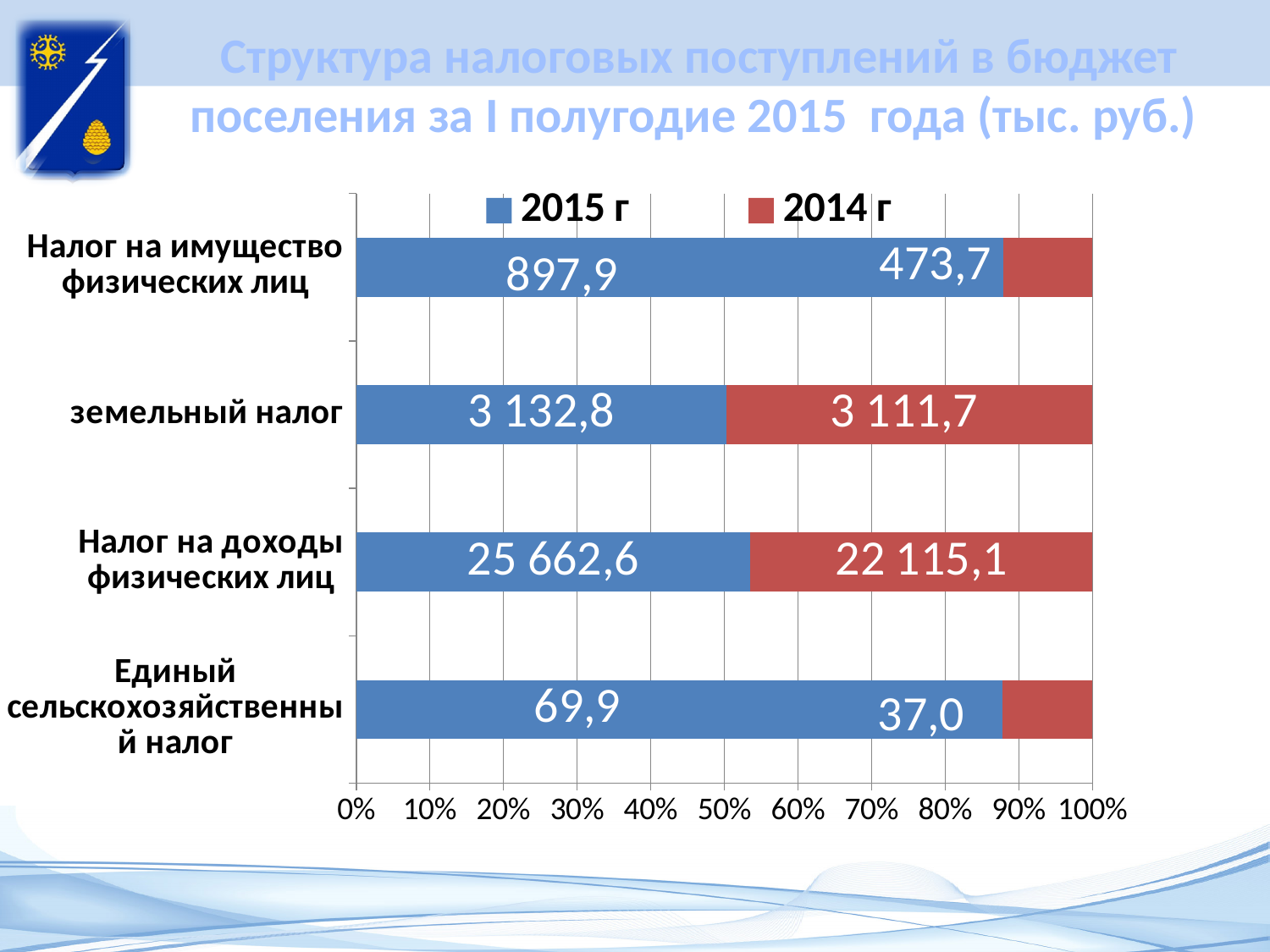
How many series does the legend list? 2 What is the value for 2014 г for Единый сельскохозяйственный налог? 37,0 Which category has the highest value for 2015 г? Налог на доходы физических лиц What is the value for 2015 г for Налог на имущество физических лиц? 897,9 What is the difference between the 2015 г and 2014 г values for Налог на имущество физических лиц? 424,2 Which category has the lowest value for 2014 г? Единый сельскохозяйственный налог What is the value for 2014 г for земельный налог? 3 111,7 For Единый сельскохозяйственный налог, which is larger: the 2015 г value or the 2014 г value? 2015 г How many categories are shown on the chart? 4 What kind of chart is shown on the slide? Bar chart What is the value for 2015 г for Налог на доходы физических лиц? 25 662,6 What is the difference between the 2015 г and 2014 г values for Налог на доходы физических лиц? 3 547,5